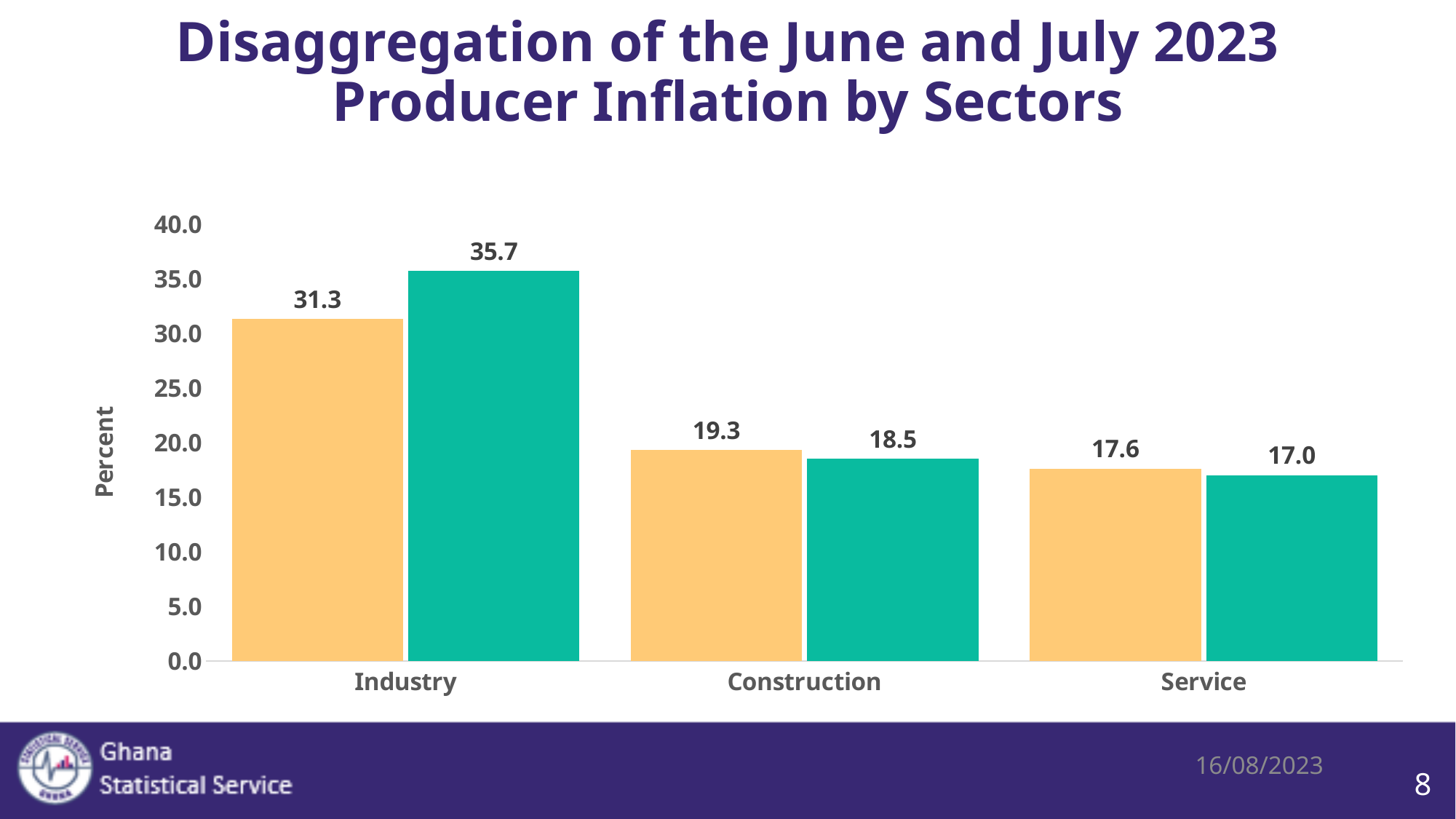
What is the label on the vertical axis of the chart? Percent What is the value of the orange bar for Construction? 19.3 What kind of chart is shown on the slide? bar chart For Construction, which bar is larger, the orange bar or the green bar? the orange bar What is the value of the orange bar for Industry? 31.3 What is the difference between the green and orange bars for Industry? 4.4 Which sector has the highest green bar? Industry What is the value of the green bar for Industry? 35.7 Is the value of the green bar for Construction greater or less than 20.0? less What is the value of the green bar for Service? 17.0 How many sectors are shown on the x axis of the chart? 3 Which sector has the lowest orange bar? Service